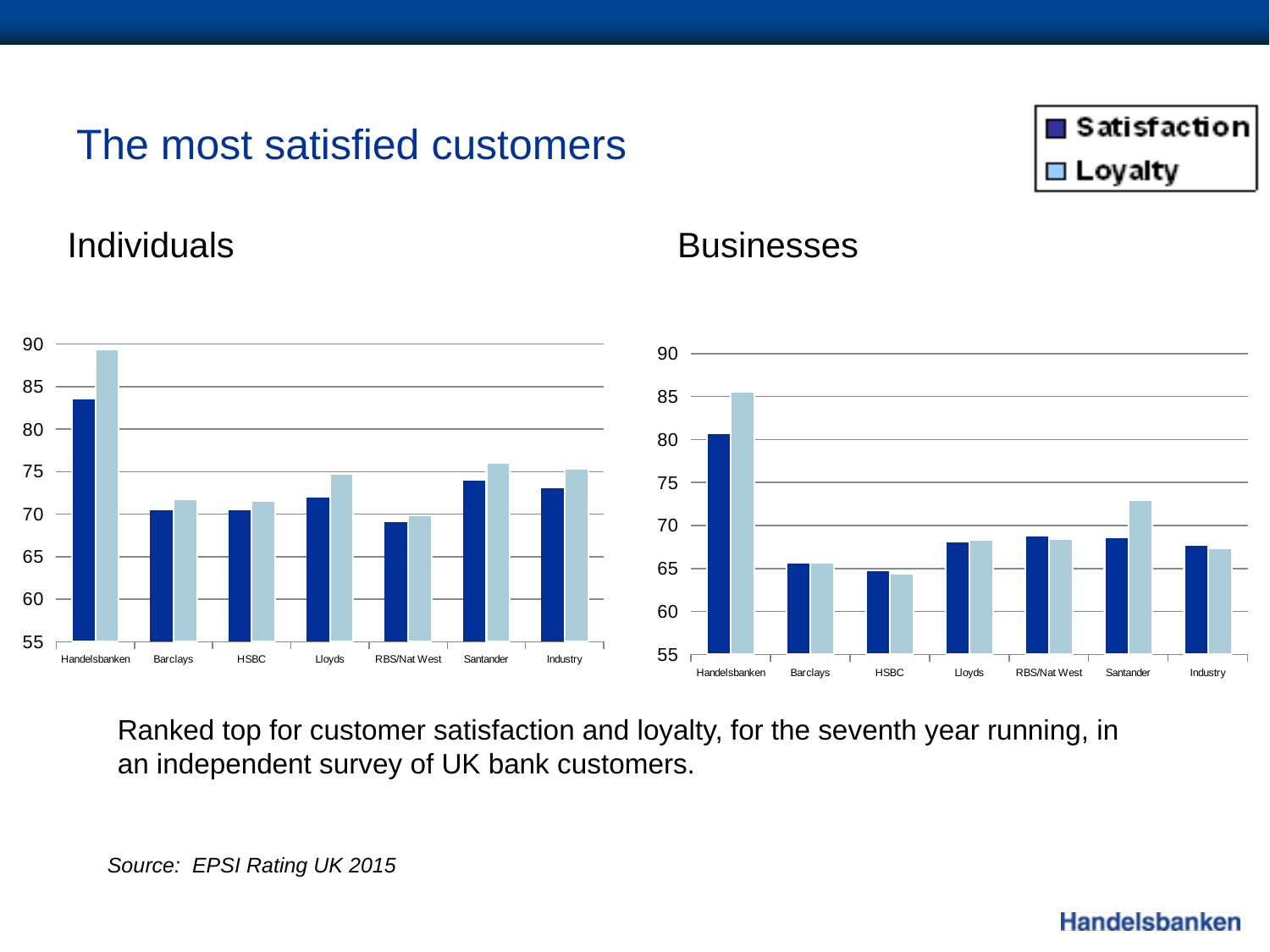
In the Businesses chart, is the Satisfaction value for Barclays greater or less than 70? less In the Individuals chart, which is larger for Santander: Satisfaction or Loyalty? Loyalty In the Businesses chart, which category has the highest Satisfaction value? Handelsbanken In the Individuals chart, is the Satisfaction value for Handelsbanken greater or less than 80? greater In the Businesses chart, is the Loyalty value for Santander greater or less than 70? greater What kind of chart is the Individuals chart? bar chart What is the source cited for the charts? EPSI Rating UK 2015 How many categories are shown on the x axis of the Businesses chart? 7 In the Individuals chart, which category has the highest Loyalty value? Handelsbanken How many series does the legend list? 2 In the Businesses chart, which category has the lowest Loyalty value? HSBC In the Individuals chart, which category has the lowest Satisfaction value? RBS/Nat West